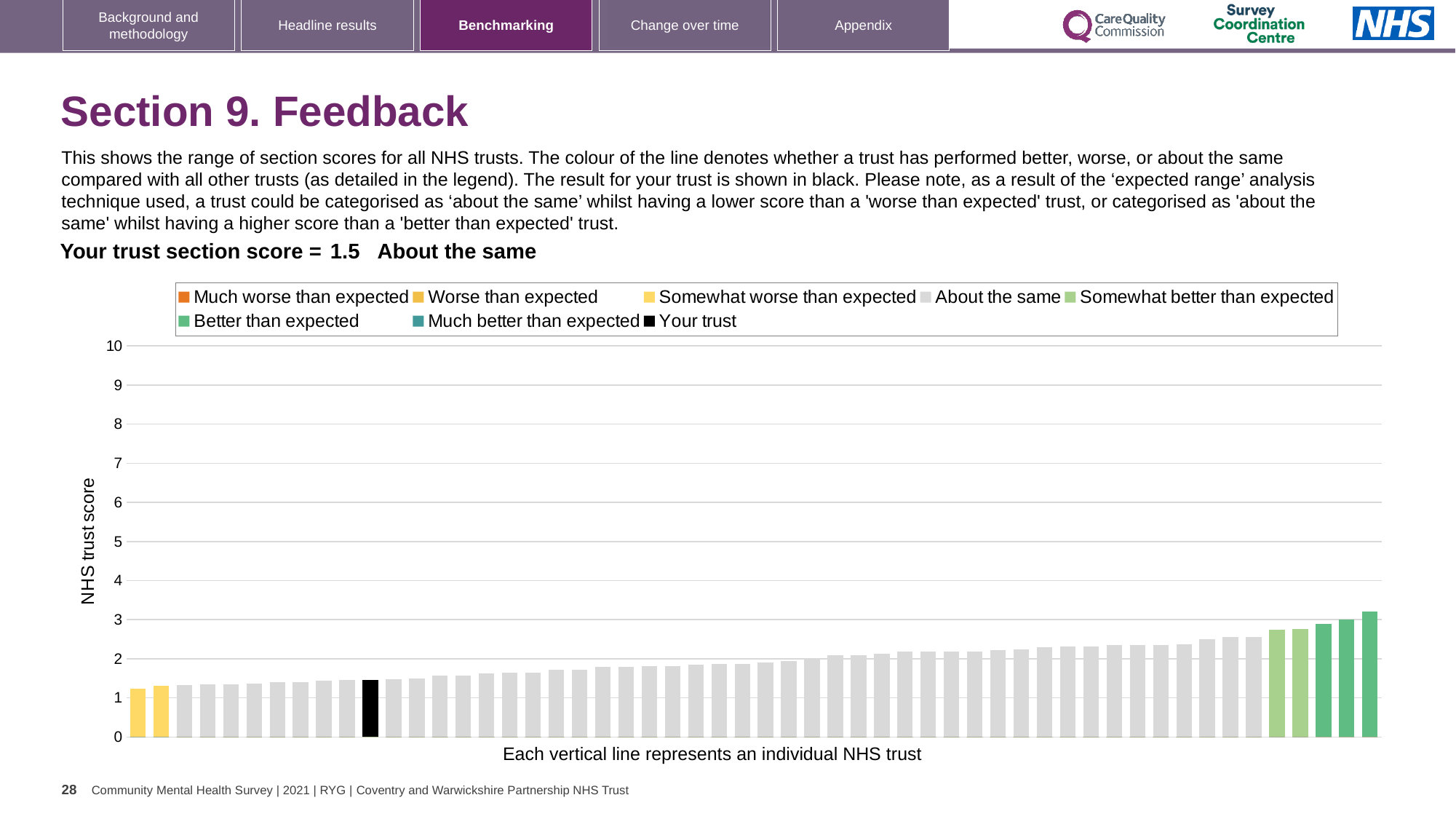
Is the value for your trust (the black bar) greater or less than 2? less What kind of chart is shown on the slide? bar chart Do the bar values rise or fall from left to right along the x axis? rise What colour is used for the bar representing your trust? black How many bars are coloured yellow (Somewhat worse than expected)? 2 Is the tallest bar in the chart greater or less than 3? greater What is the label on the y axis of the chart? NHS trust score Which category is your trust placed in for this section? About the same Is the shortest bar in the chart greater or less than 2? less How many bars are coloured dark green (Better than expected)? 3 How many entries does the chart legend list? 8 What is the section score for your trust shown on the slide? 1.5